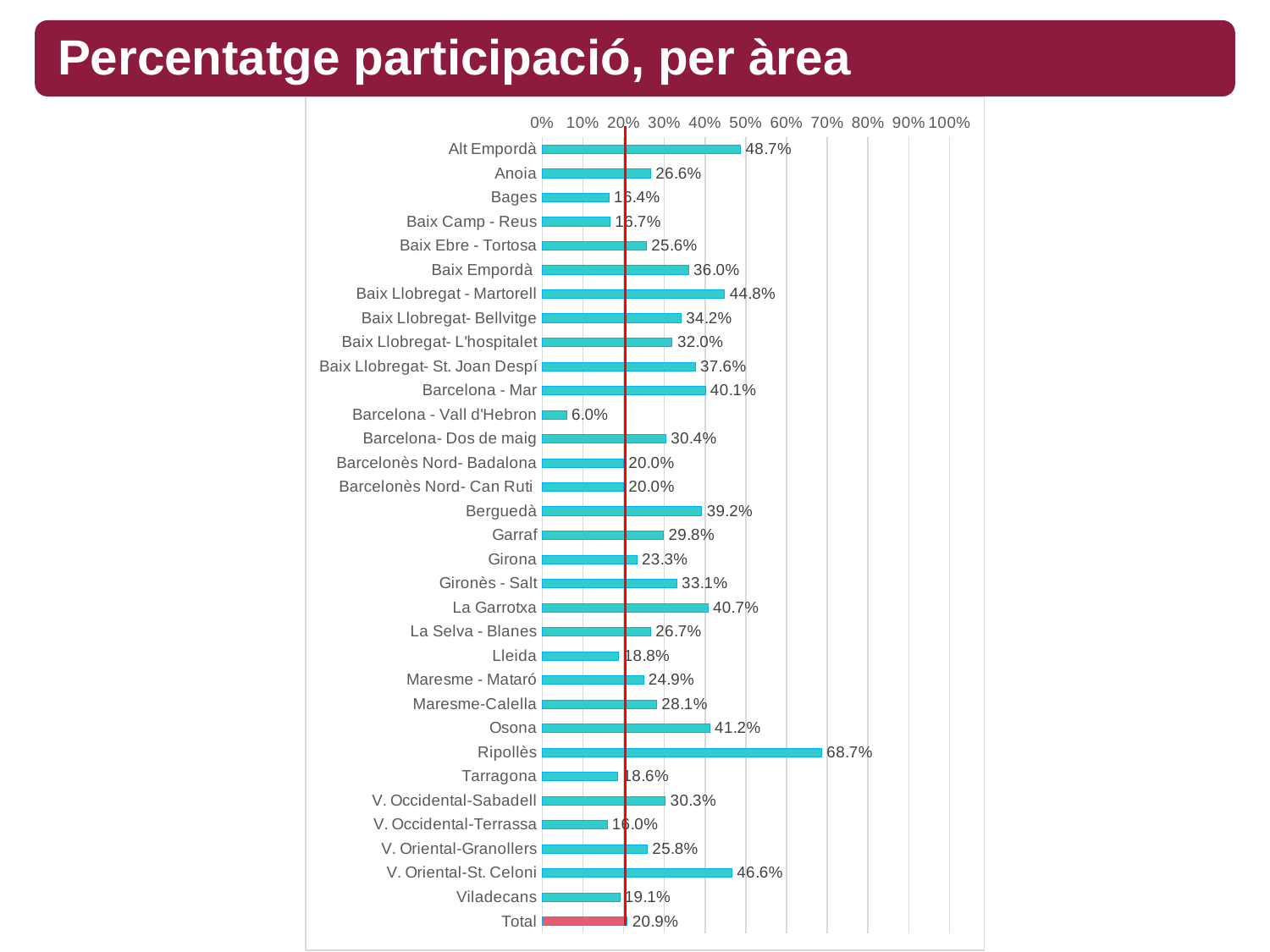
Is the value for Ripollès greater or less than 60%? greater What is the participation percentage for Baix Llobregat - Martorell? 44.8% Which area has the highest participation percentage? Ripollès What type of chart is shown on the slide? Bar chart Which has a higher participation percentage, V. Oriental-St. Celoni or Osona? V. Oriental-St. Celoni Which area has the lowest participation percentage? Barcelona - Vall d'Hebron What is the difference in percentage points between Ripollès and Alt Empordà? 20.0 What is the value shown for the Total bar? 20.9% What is the difference in percentage points between Baix Empordà and Baix Ebre - Tortosa? 10.4 What is the participation percentage for Ripollès? 68.7% What is the participation percentage for Barcelona - Mar? 40.1% How many bars are shown in the chart, including Total? 33